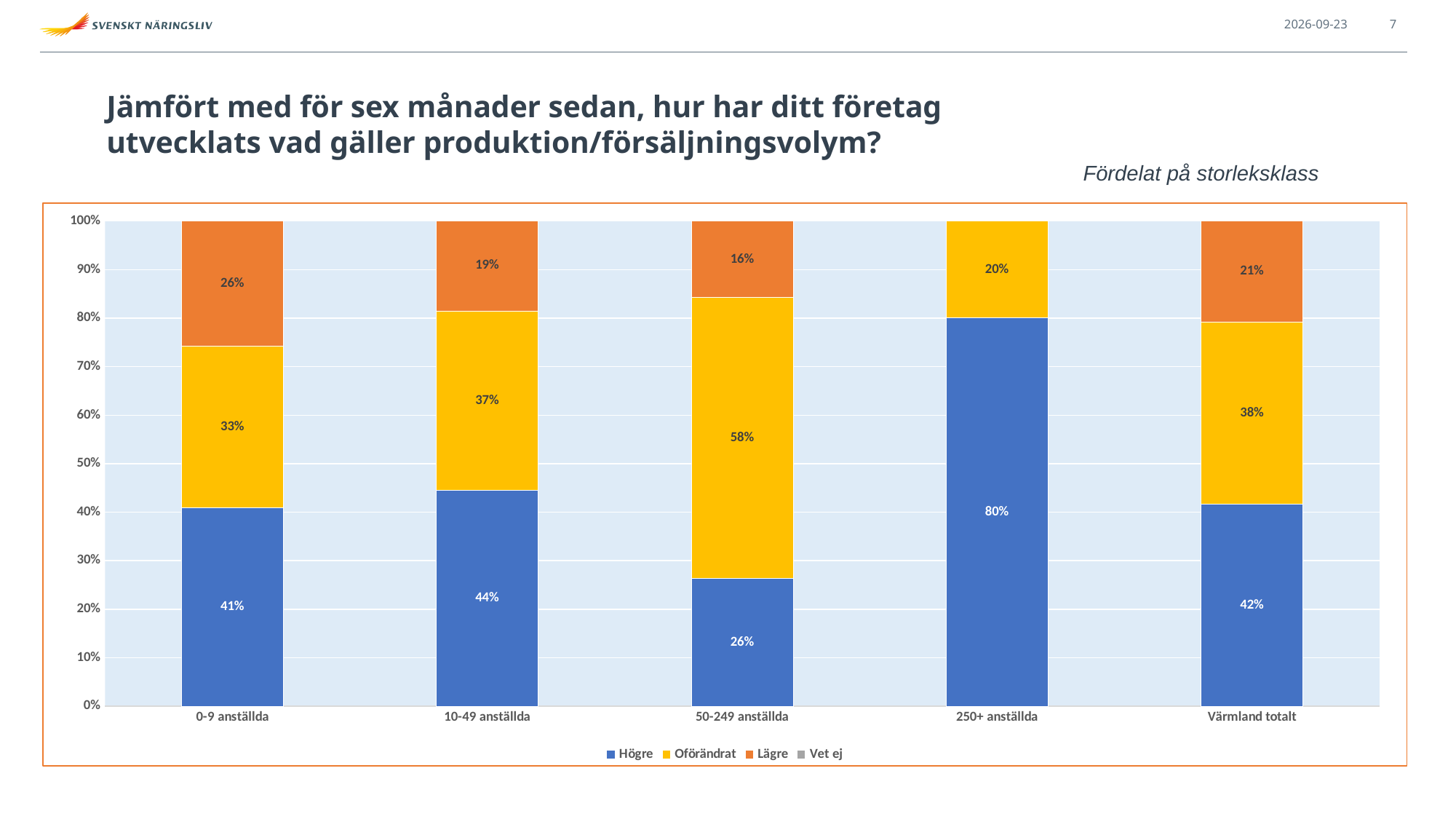
What is the value for Högre in the 250+ anställda category? 80% What is the difference between the Lägre values for 0-9 anställda and 10-49 anställda? 7% Which is larger: the Oförändrat value for 10-49 anställda or for Värmland totalt? Värmland totalt Which category has the lowest value for Högre? 50-249 anställda What is the value for Lägre in the Värmland totalt category? 21% How many categories are shown on the x axis? 5 What kind of chart is shown on the slide? Stacked bar chart Which category has the highest value for Högre? 250+ anställda What is the value for Högre in the 0-9 anställda category? 41% What is the value for Oförändrat in the 50-249 anställda category? 58% How many series does the legend list? 4 Which series is shown in orange in the legend? Lägre